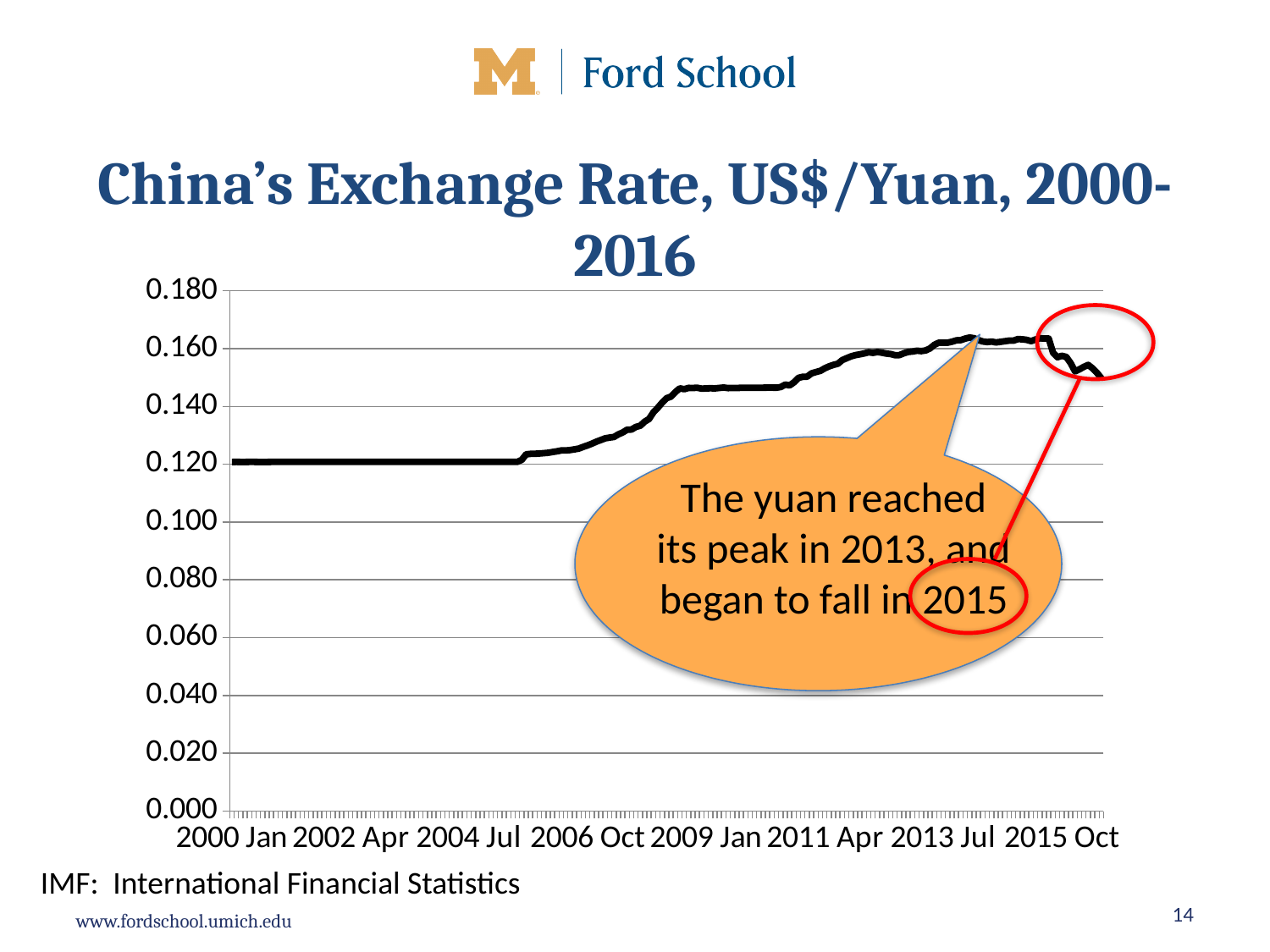
How many date labels are shown on the x axis? 8 Which is larger, the exchange rate at 2000 Jan or at 2013 Jul? 2013 Jul What is the title of the chart? China's Exchange Rate, US$/Yuan, 2000-2016 Is the exchange rate value at 2004 Jul greater or less than 0.140? less Is the exchange rate value at 2013 Jul greater or less than 0.140? greater Is the exchange rate value at 2000 Jan greater or less than 0.140? less Does the exchange rate rise or fall after 2015? fall According to the callout on the chart, in which year did the yuan reach its peak? 2013 What kind of chart is shown on the slide? line chart Does the exchange rate generally rise or fall between 2004 Jul and 2013 Jul? rise